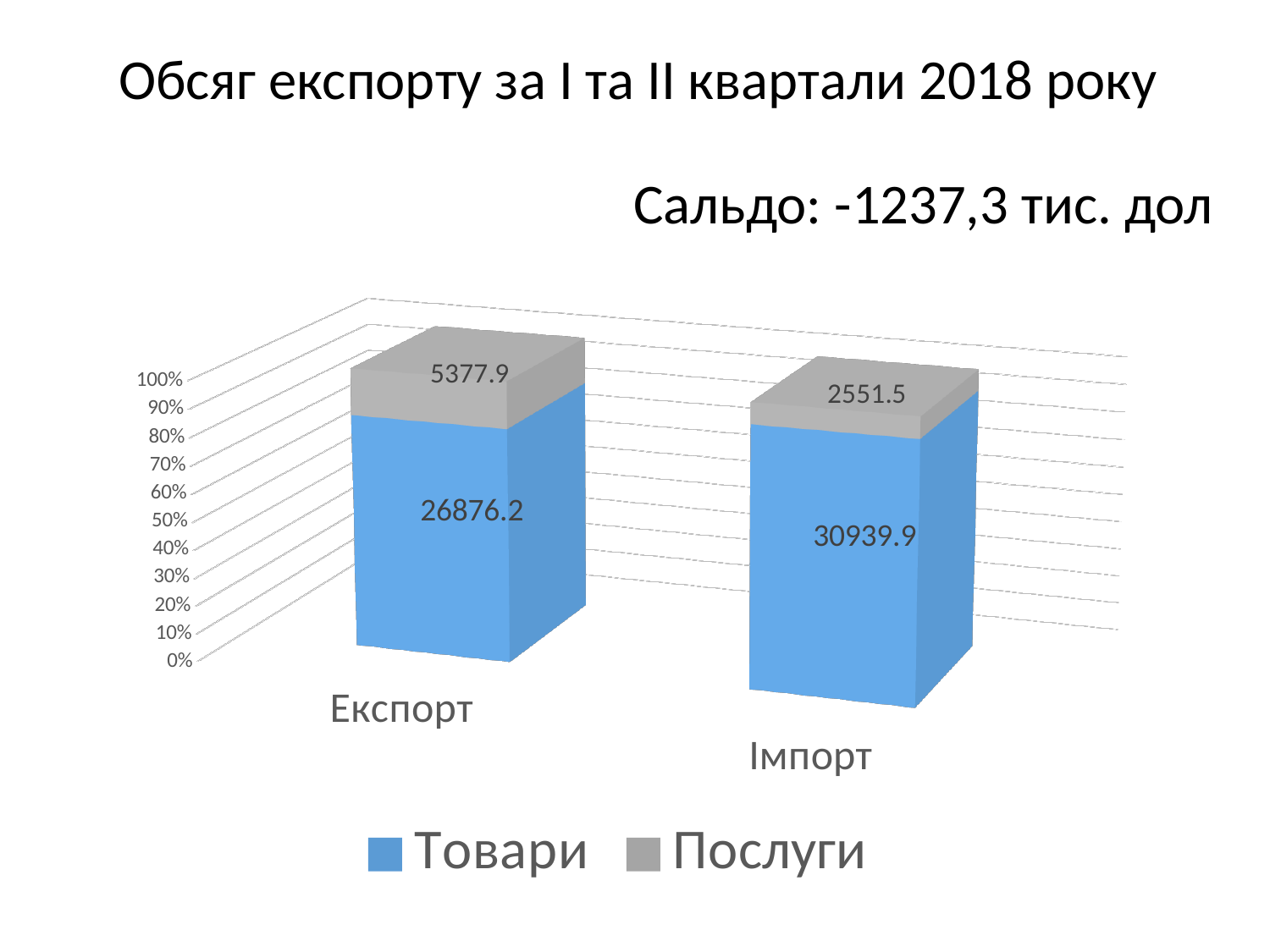
Which category has the lower value for Послуги? Імпорт What is the value of Послуги for Експорт? 5377.9 What is the total of the stacked bar for Імпорт? 33491.4 What kind of chart is shown on the slide? Stacked bar chart Which category has the higher value for Товари, Експорт or Імпорт? Імпорт What is the difference between the Послуги values for Експорт and Імпорт? 2826.4 What is the value of Товари for Імпорт? 30939.9 What is the difference between the Товари values for Імпорт and Експорт? 4063.7 What is the value of Послуги for Імпорт? 2551.5 What is the total of the stacked bar for Експорт? 32254.1 How many series does the legend list? 2 What is the value of Товари for Експорт? 26876.2